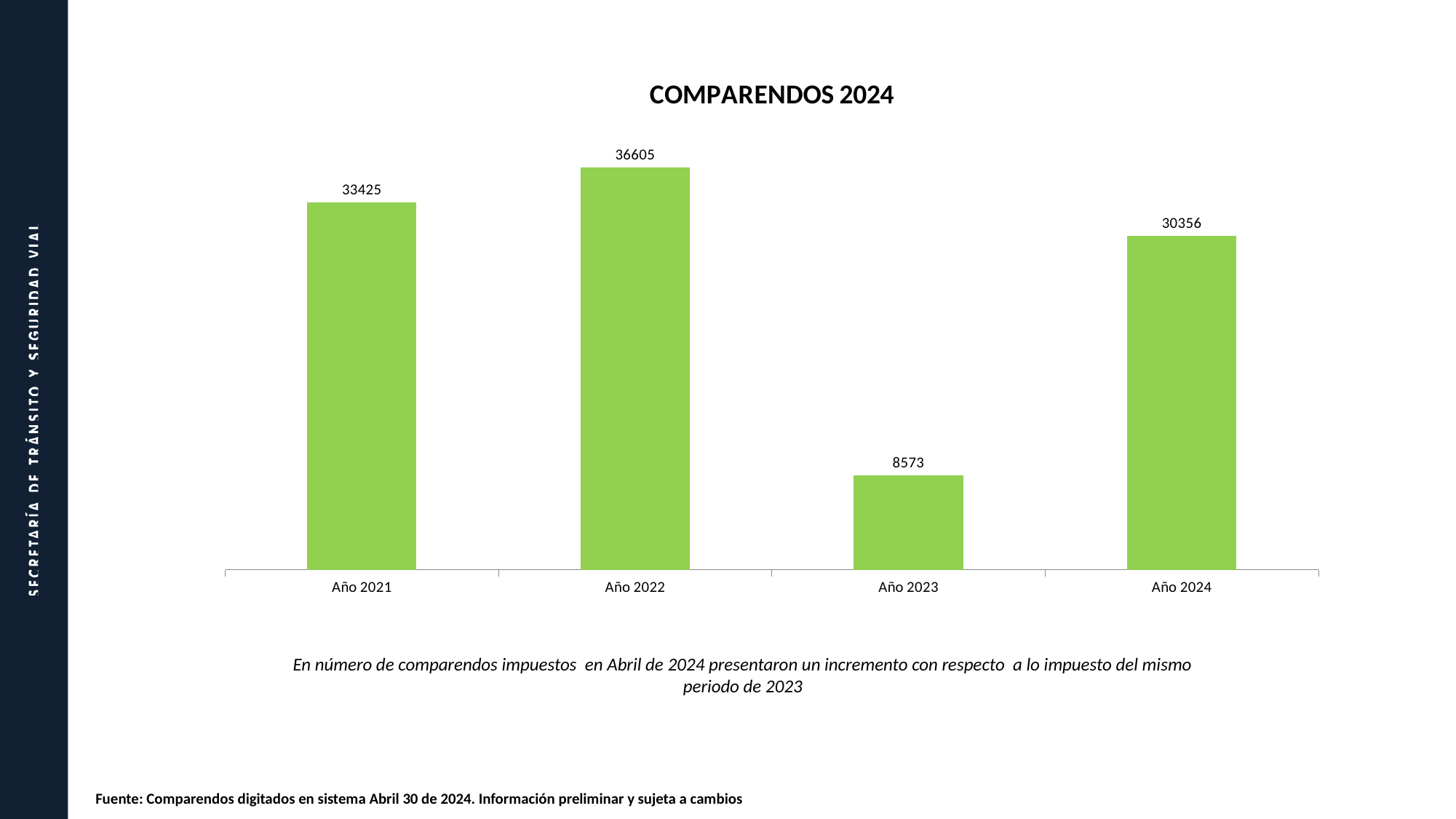
What is the value for Año 2021? 33425 What is the value for Año 2023? 8573 How many years are shown on the chart? 4 What is the title of the chart? COMPARENDOS 2024 What is the difference between the values for Año 2022 and Año 2021? 3180 Which is larger, the value for Año 2021 or the value for Año 2024? Año 2021 Which year has the highest value? Año 2022 What is the value for Año 2024? 30356 Which year has the lowest value? Año 2023 What is the difference between the values for Año 2024 and Año 2023? 21783 What is the value for Año 2022? 36605 What kind of chart is shown on the slide? Bar chart